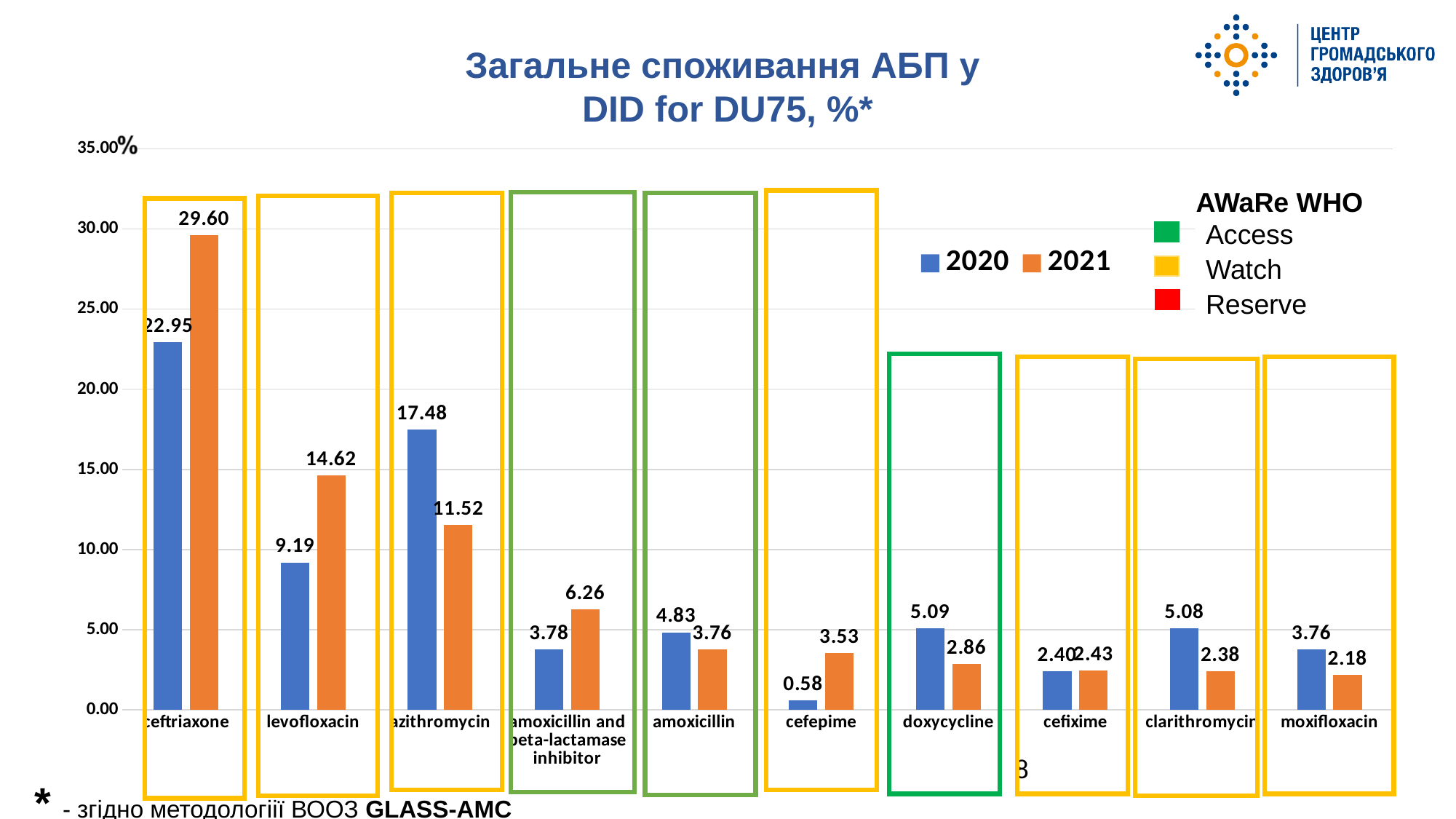
How many data series does the chart legend list? 2 What is the difference between the 2021 and 2020 values for ceftriaxone? 6.65 What type of chart is shown on the slide? bar chart What is the 2020 value for azithromycin? 17.48 How many antibiotics are shown on the x axis? 10 What is the 2021 value for ceftriaxone? 29.60 What is the 2021 value for levofloxacin? 14.62 Which antibiotic has the lowest 2020 value? cefepime What is the 2020 value for cefepime? 0.58 Which colour represents the 2021 series? orange Which antibiotic has the highest 2021 value? ceftriaxone Which is larger for doxycycline, the 2020 value or the 2021 value? 2020